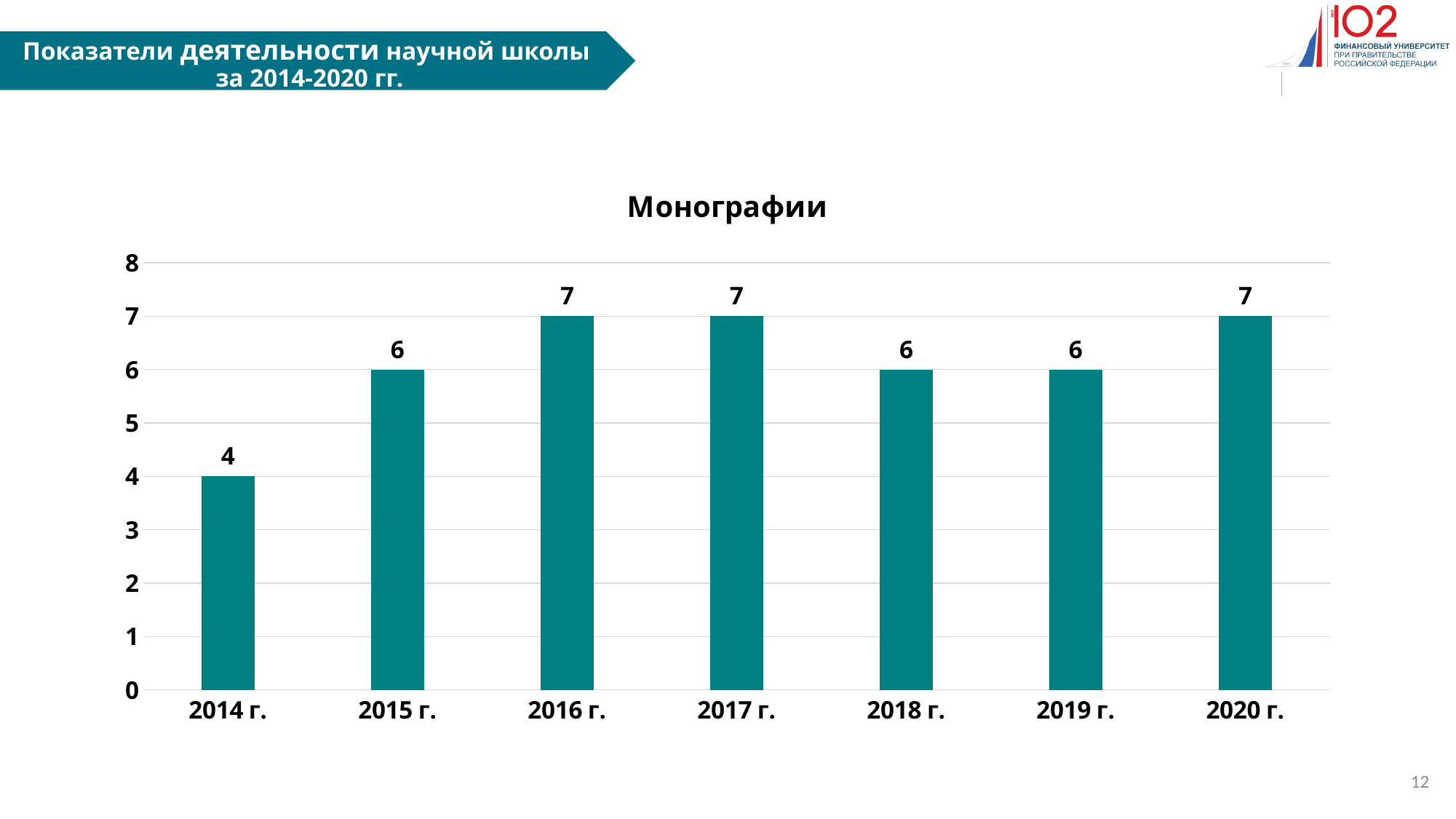
How many years are shown on the x axis of the chart? 7 What is the difference between the values for 2020 г. and 2019 г.? 1 What is the highest value shown on the y axis of the chart? 8 Which is larger, the value for 2015 г. or the value for 2016 г.? 2016 г. What is the title of the chart? Монографии What is the difference between the values for 2016 г. and 2014 г.? 3 What is the value for 2014 г. in the Монографии chart? 4 Which year has the lowest value in the Монографии chart? 2014 г. Is the value for 2014 г. greater or less than 5? less What is the value for 2019 г. in the Монографии chart? 6 What is the value for 2017 г. in the Монографии chart? 7 What kind of chart is shown on the slide? bar chart